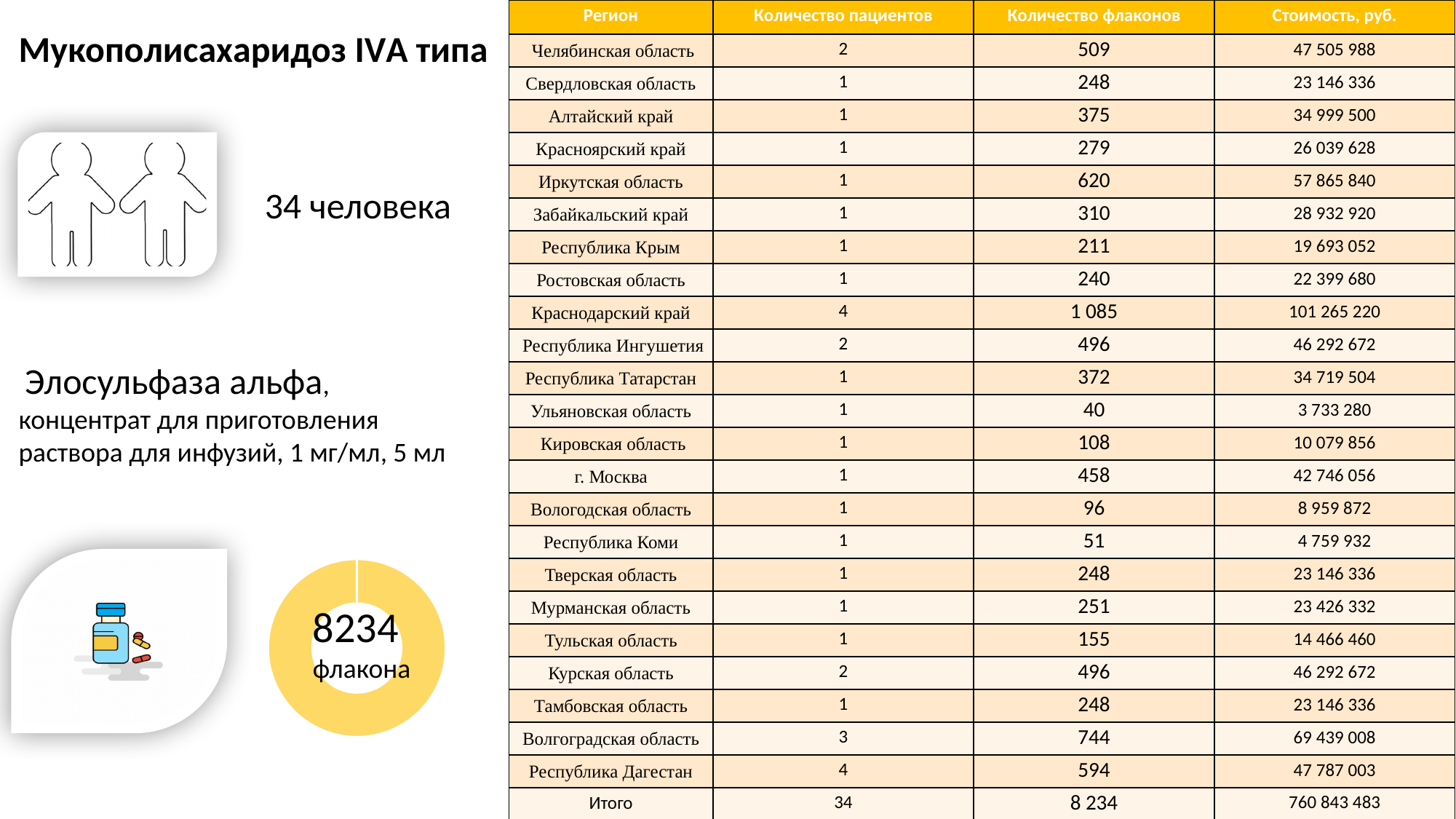
In the table, how many флаконов are listed for Краснодарский край? 1 085 In the table, which region has the lowest Количество флаконов? Ульяновская область What value is printed in the centre of the donut chart? 8234 In the table, which region has the highest Количество флаконов? Краснодарский край What kind of chart is shown at the bottom left of the slide? donut chart In the table, what is the Итого value for Количество флаконов? 8 234 How many visible segments does the donut chart ring have? 1 In the table, what is the Итого value for Стоимость, руб.? 760 843 483 What unit label appears under the number in the centre of the donut chart? флакона What colour is the ring of the donut chart? yellow In the table, which has more флаконов: Иркутская область or Челябинская область? Иркутская область In the table, what is the difference in Количество флаконов between Волгоградская область and Республика Дагестан? 150